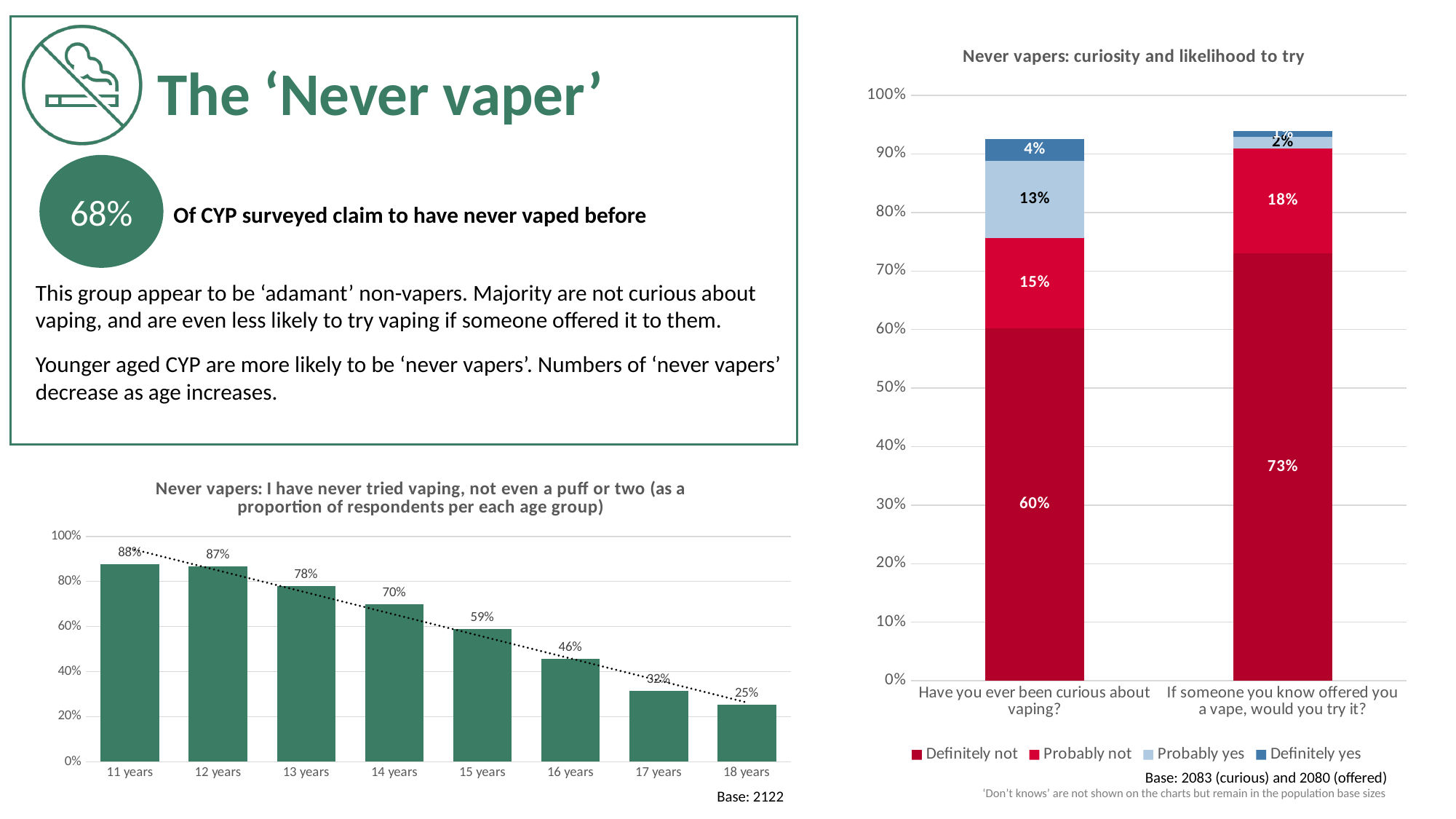
In the chart 'Never vapers: curiosity and likelihood to try', how many series does the legend list? 4 In the chart 'Never vapers: I have never tried vaping, not even a puff or two', what is the difference between the values for 13 years and 16 years? 32% In the chart 'Never vapers: curiosity and likelihood to try', what is the 'Probably yes' value for 'Have you ever been curious about vaping?'? 13% In the chart 'Never vapers: I have never tried vaping, not even a puff or two', do the values rise or fall as age increases along the x axis? fall In the chart 'Never vapers: curiosity and likelihood to try', which question has the larger 'Probably not' value? If someone you know offered you a vape, would you try it? What kind of chart is 'Never vapers: I have never tried vaping, not even a puff or two'? bar chart In the chart 'Never vapers: curiosity and likelihood to try', what is the total of the stacked bar for 'Have you ever been curious about vaping?'? 92% In the chart 'Never vapers: I have never tried vaping, not even a puff or two', which age group has the highest value? 11 years In the chart 'Never vapers: I have never tried vaping, not even a puff or two', how many age groups are shown? 8 In the chart 'Never vapers: curiosity and likelihood to try', what is the 'Definitely not' value for 'If someone you know offered you a vape, would you try it?'? 73% In the chart 'Never vapers: I have never tried vaping, not even a puff or two', which age group has the lowest value? 18 years In the chart 'Never vapers: I have never tried vaping, not even a puff or two', what is the value for 14 years? 70%